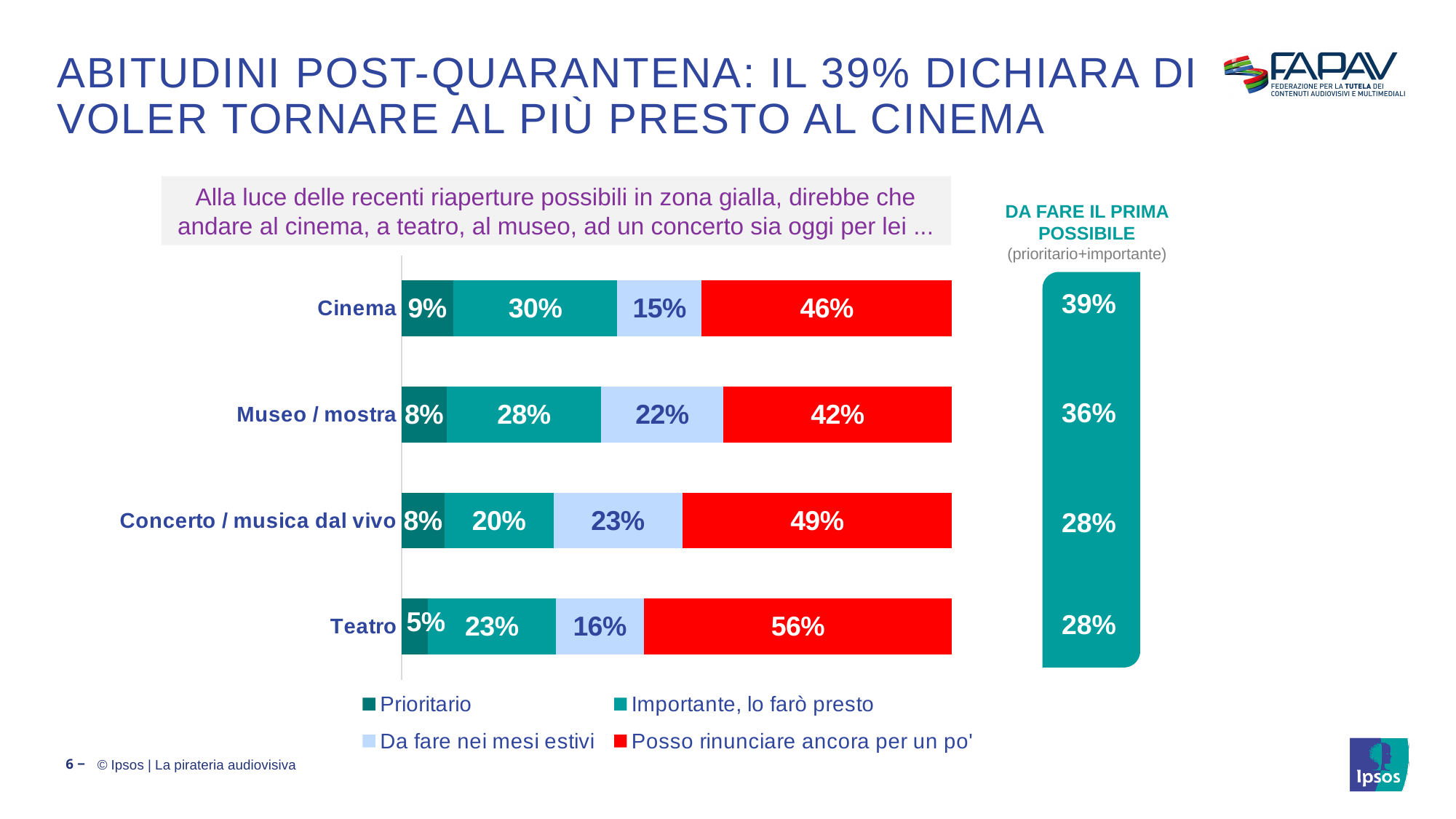
What is the 'Da fare nei mesi estivi' value for Concerto / musica dal vivo? 23% Which category has the lowest 'Prioritario' value? Teatro Which category has the highest 'Posso rinunciare ancora per un po'' value? Teatro What kind of chart is used to show the responses by category? Stacked bar chart What is the difference between the 'Posso rinunciare ancora per un po'' values for Teatro and Cinema? 10% In the 'DA FARE IL PRIMA POSSIBILE' column, what is the value for Cinema? 39% What is the 'Importante, lo farò presto' value for Museo / mostra? 28% How many categories are shown in the stacked bar chart? 4 What is the 'Posso rinunciare ancora per un po'' value for Teatro? 56% What percentage of respondents say going to the cinema is 'Prioritario'? 9% How many series does the legend list? 4 Which is larger: the 'Da fare nei mesi estivi' value for Museo / mostra or for Cinema? Museo / mostra